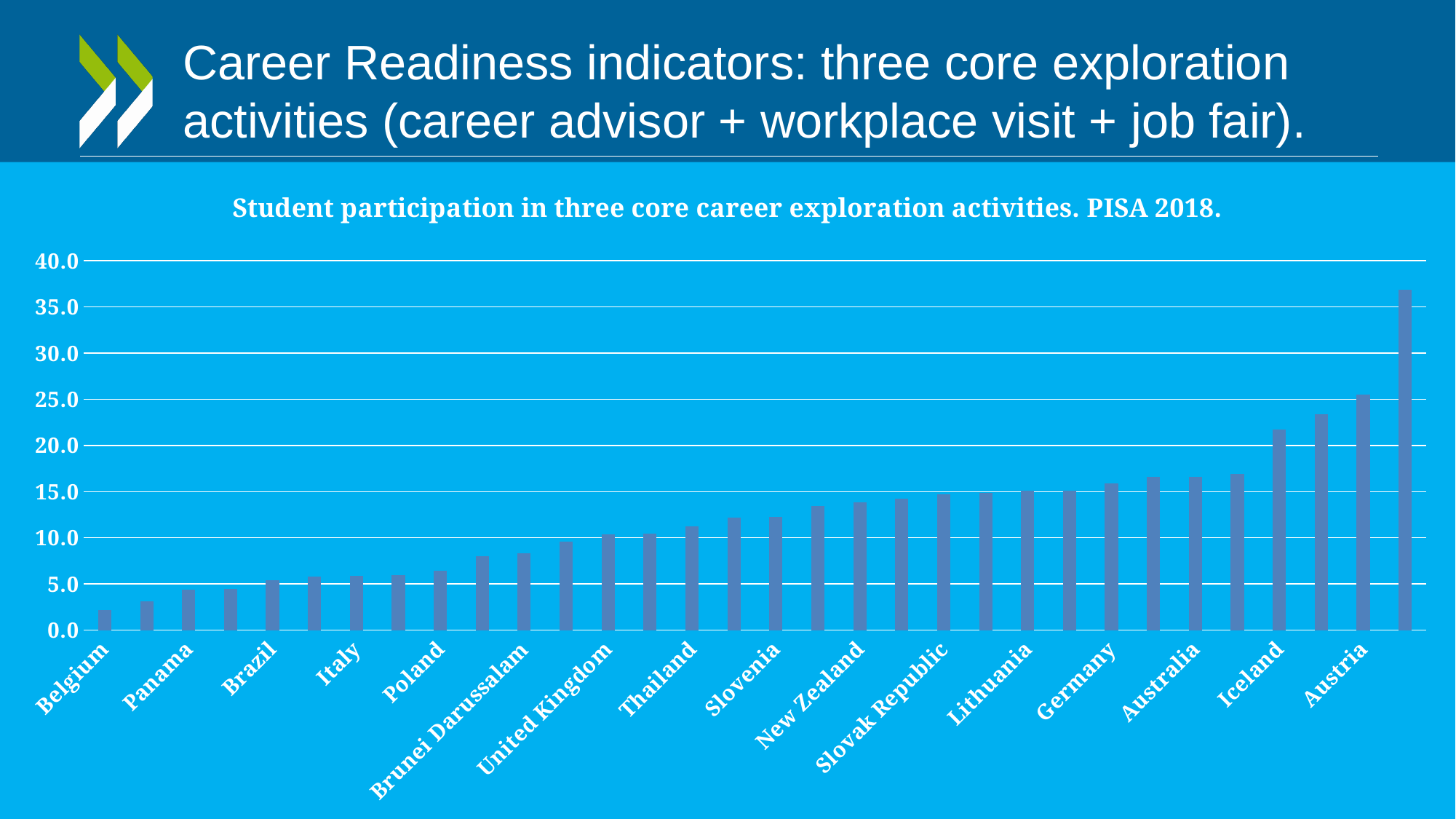
Is the value for Belgium greater or less than 5.0? less Which country has the lowest value in the chart? Belgium Which has the larger value, Iceland or Australia? Iceland Do the values rise or fall moving from left to right along the x axis? rise Is the value for Austria greater or less than 35.0? less What kind of chart is shown on the slide? bar chart Is the value for Thailand greater or less than 10.0? greater What is the title of the chart? Student participation in three core career exploration activities. PISA 2018.